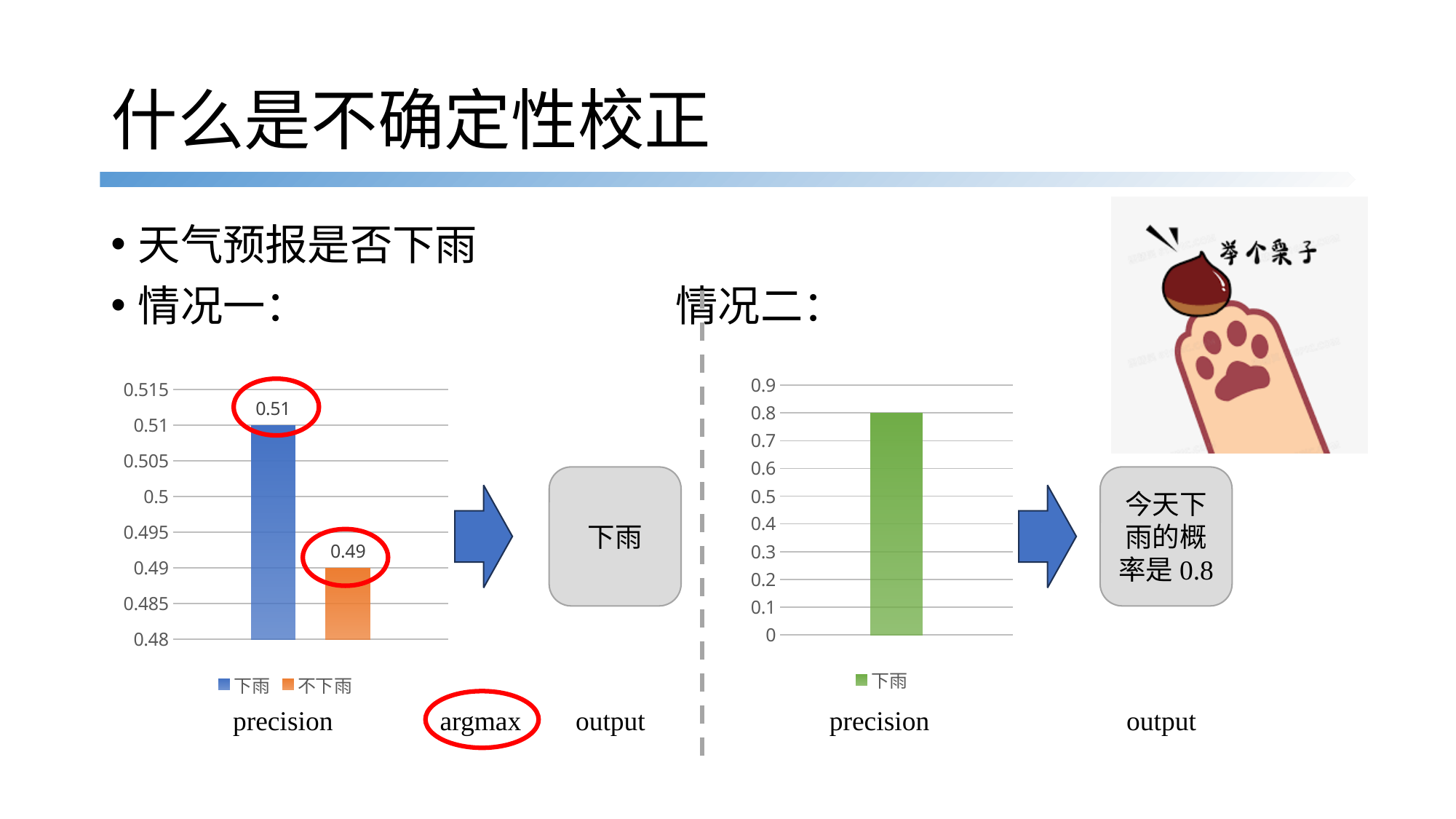
In the left chart (情况一), which series has the higher value, 下雨 or 不下雨? 下雨 In the left chart (情况一), what is the difference between the values for 下雨 and 不下雨? 0.02 In the right chart (情况二), how many series does the legend list? 1 In the left chart (情况一), how many series does the legend list? 2 In the right chart (情况二), what colour is the 下雨 bar? green What kind of chart is the left chart (情况一)? bar chart In the right chart (情况二), is the value for 下雨 greater or less than 0.5? greater In the left chart (情况一), is the value for 不下雨 greater or less than 0.5? less In the right chart (情况二), what value does the 下雨 bar reach? 0.8 In the left chart (情况一), what is the value for 下雨? 0.51 In the left chart (情况一), what colour is the 不下雨 bar? orange In the left chart (情况一), what is the value for 不下雨? 0.49